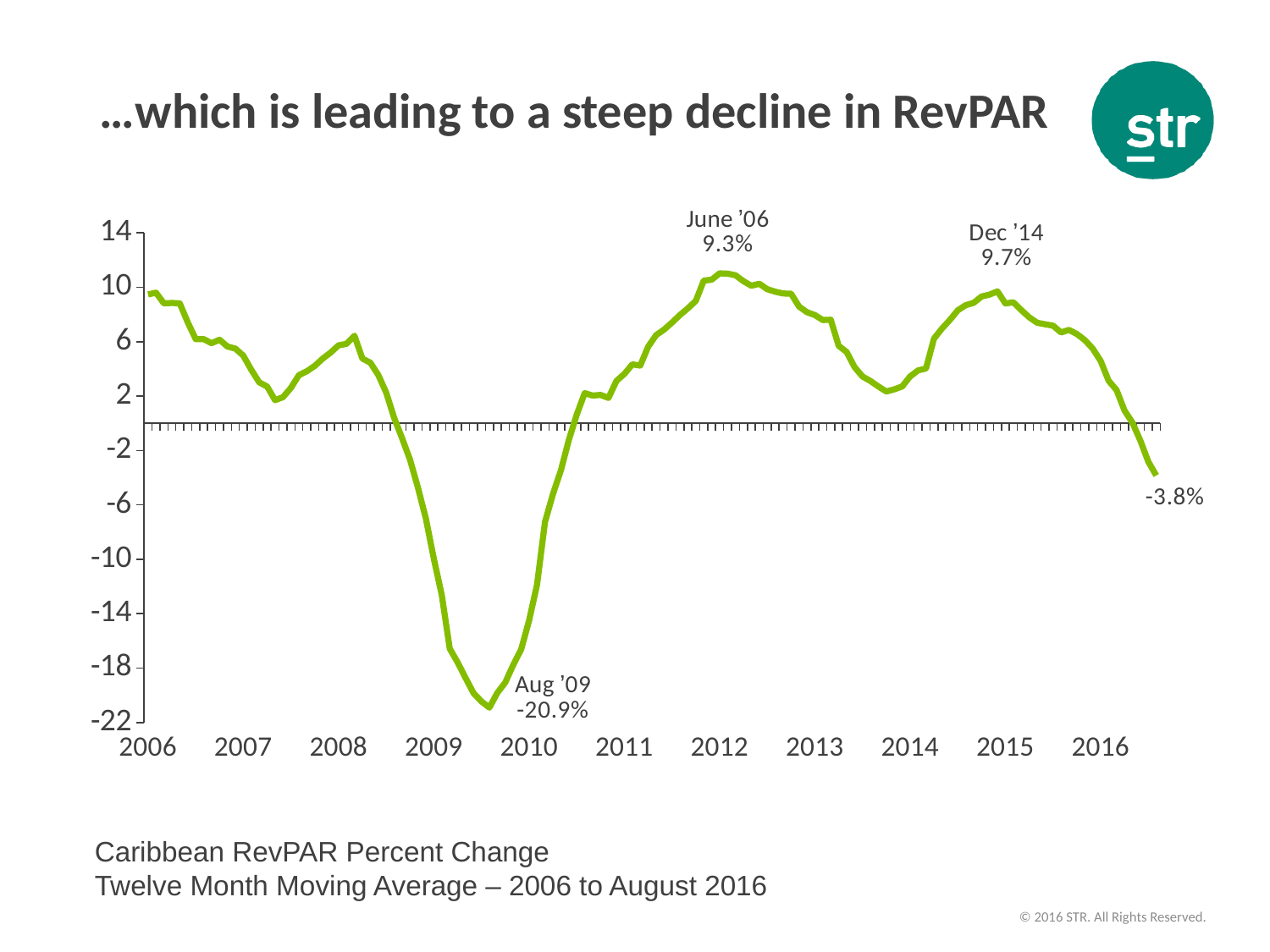
What value is labeled at the end of the line, in 2016? -3.8% Is the value at the start of 2006 greater or less than 6? greater What kind of chart is shown on the slide? Line chart Which labeled point has the higher value, Dec '14 or June '06? Dec '14 What value is labeled for Dec '14? 9.7% What does the caption below the chart say the chart shows? Caribbean RevPAR Percent Change, Twelve Month Moving Average – 2006 to August 2016 Which labeled point on the line has the lowest value? Aug '09 How many year labels are shown on the x axis? 11 Does the line rise or fall between 2015 and the end of the series in 2016? Fall What is the difference between the Dec '14 value and the Aug '09 value? 30.6 percentage points What value is labeled at the Aug '09 low point of the line? -20.9% What value is labeled for June '06? 9.3%